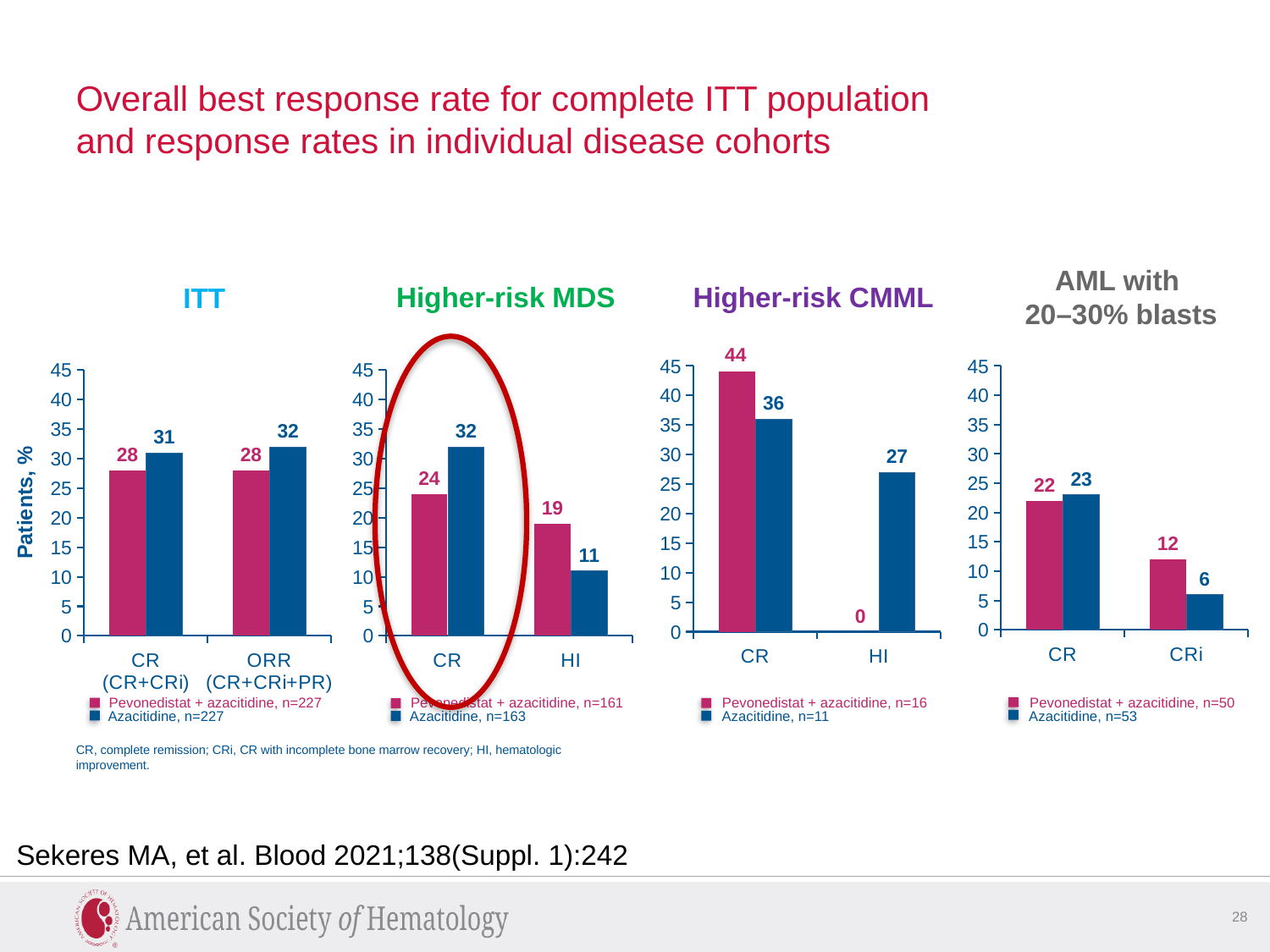
In the AML with 20–30% blasts chart, what is the value for Azacitidine at CRi? 6 How many categories are shown on the x axis of the Higher-risk MDS chart? 2 In the ITT chart, what is the value for Azacitidine at ORR (CR+CRi+PR)? 32 In the Higher-risk MDS chart, what is the value for Azacitidine at CR? 32 How many series does the legend of the ITT chart list? 2 What kind of chart is the Higher-risk CMML chart? Bar chart In the Higher-risk CMML chart, is the value for Pevonedistat + azacitidine at CR greater or less than 40? greater In the Higher-risk MDS chart, what is the difference between the Pevonedistat + azacitidine and Azacitidine values at HI? 8 In the Higher-risk CMML chart, what is the value for Pevonedistat + azacitidine at HI? 0 In the Higher-risk CMML chart, which category has the highest value for Pevonedistat + azacitidine? CR In the AML with 20–30% blasts chart, which is larger at CRi: Pevonedistat + azacitidine or Azacitidine? Pevonedistat + azacitidine In the ITT chart, what is the value for Pevonedistat + azacitidine at CR (CR+CRi)? 28